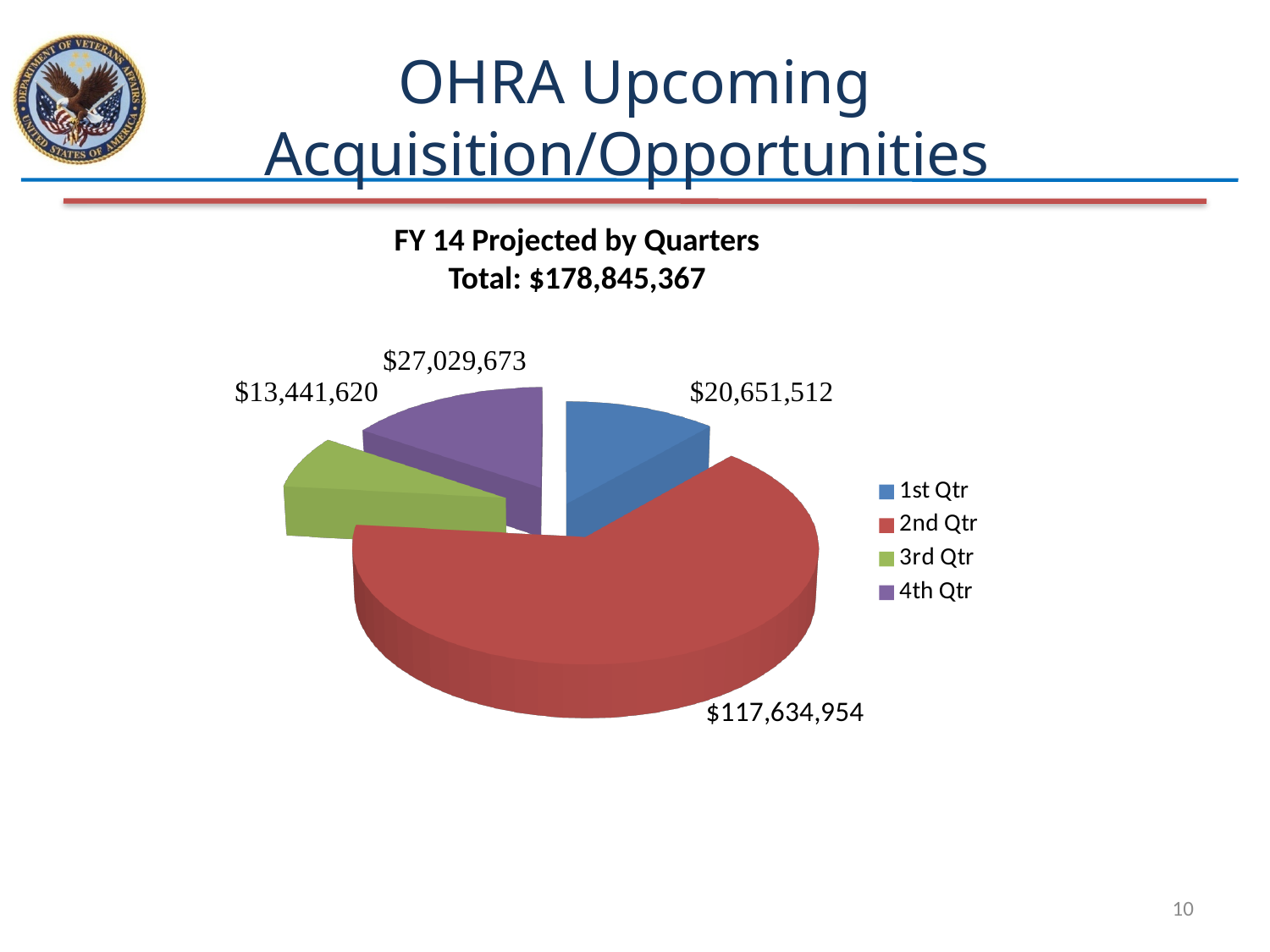
Which quarter has the largest value? 2nd Qtr Which quarter has the smallest value? 3rd Qtr What is the difference between the 2nd Qtr and 1st Qtr values? $96,983,442 What is the difference between the 4th Qtr and 3rd Qtr values? $13,588,053 What is the value for 1st Qtr? $20,651,512 What is the value for 2nd Qtr? $117,634,954 What is the value for 3rd Qtr? $13,441,620 What total is stated in the chart title? $178,845,367 How many slices does the pie chart have? 4 What is the value for 4th Qtr? $27,029,673 Which is larger, the value for 4th Qtr or the value for 1st Qtr? 4th Qtr What kind of chart is shown on the slide? Pie chart